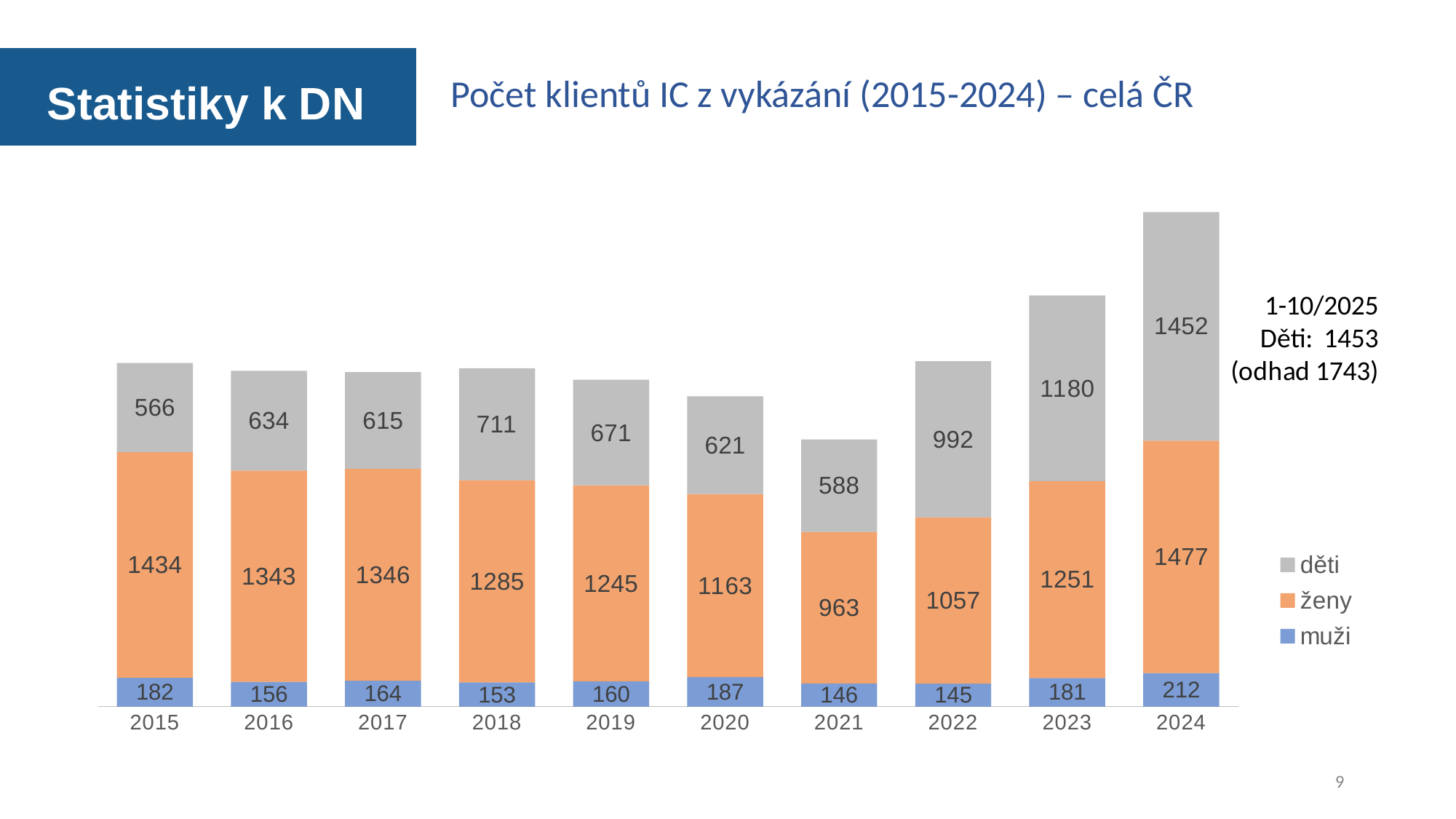
In which year is the value for ženy lowest? 2021 What is the value for děti in 2021? 588 What is the value for ženy in 2015? 1434 What kind of chart is shown on the slide? Stacked bar chart In which year is the value for děti highest? 2024 In which year is the value for muži lowest? 2022 What is the total of the stacked bar for 2024? 3141 What is the value for muži in 2024? 212 Which is larger, the muži value for 2020 or for 2023? 2020 How many years are shown on the x axis? 10 What is the difference between the děti values for 2024 and 2023? 272 How many series does the legend list? 3